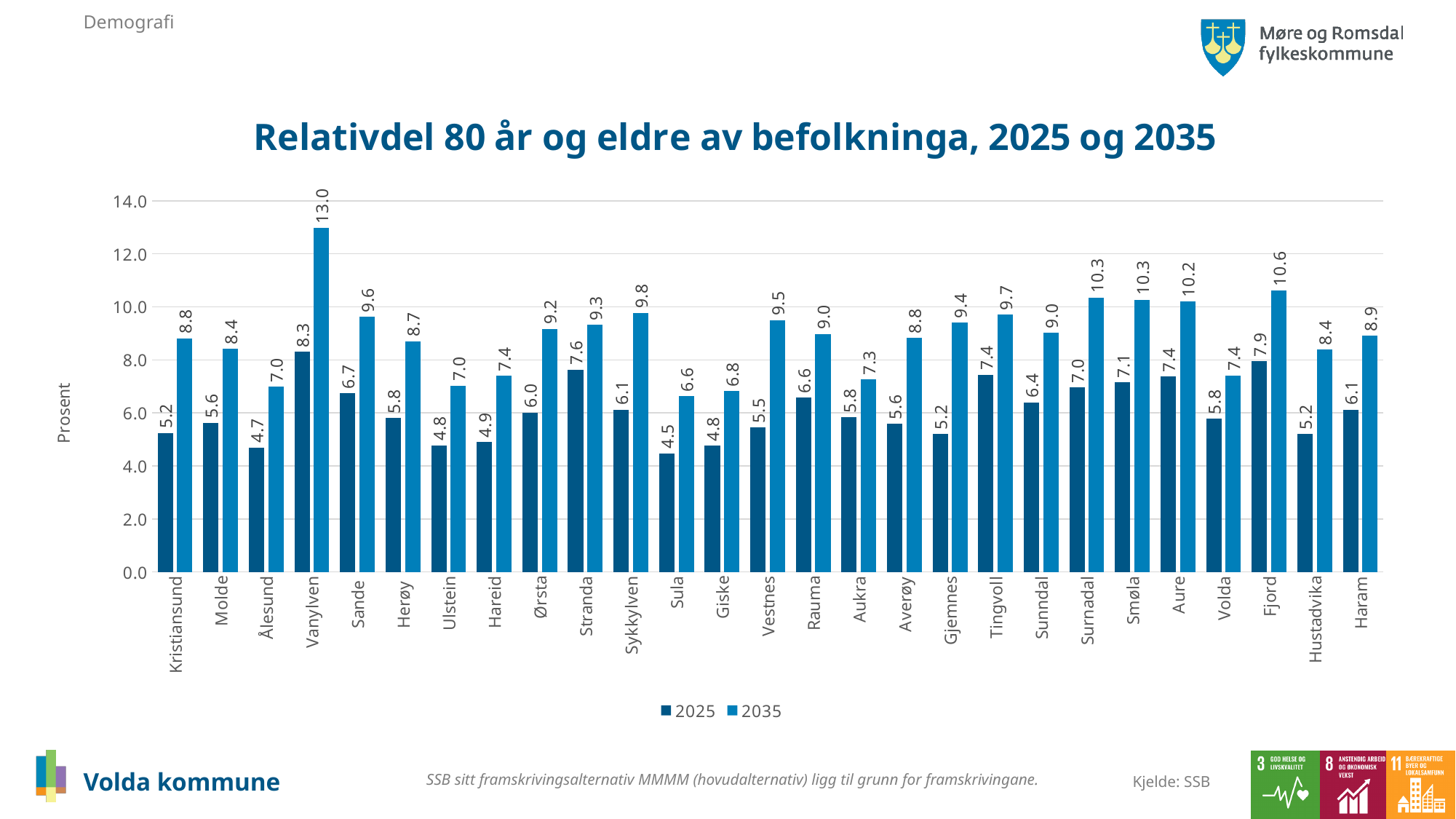
What is the 2035 value for Volda? 7.4 Which municipality has the highest 2035 value? Vanylven How many series does the legend list? 2 What is the 2035 value for Fjord? 10.6 Which is larger, the 2035 value for Surnadal or the 2035 value for Aure? Surnadal What is the difference between the 2035 and 2025 values for Vanylven? 4.7 How many municipalities are shown on the x axis? 27 What is the 2025 value for Vanylven? 8.3 Is the 2025 value for Stranda greater or less than 8.0? less What kind of chart is shown? bar chart Which municipality has the lowest 2025 value? Sula What is the title of the chart? Relativdel 80 år og eldre av befolkninga, 2025 og 2035